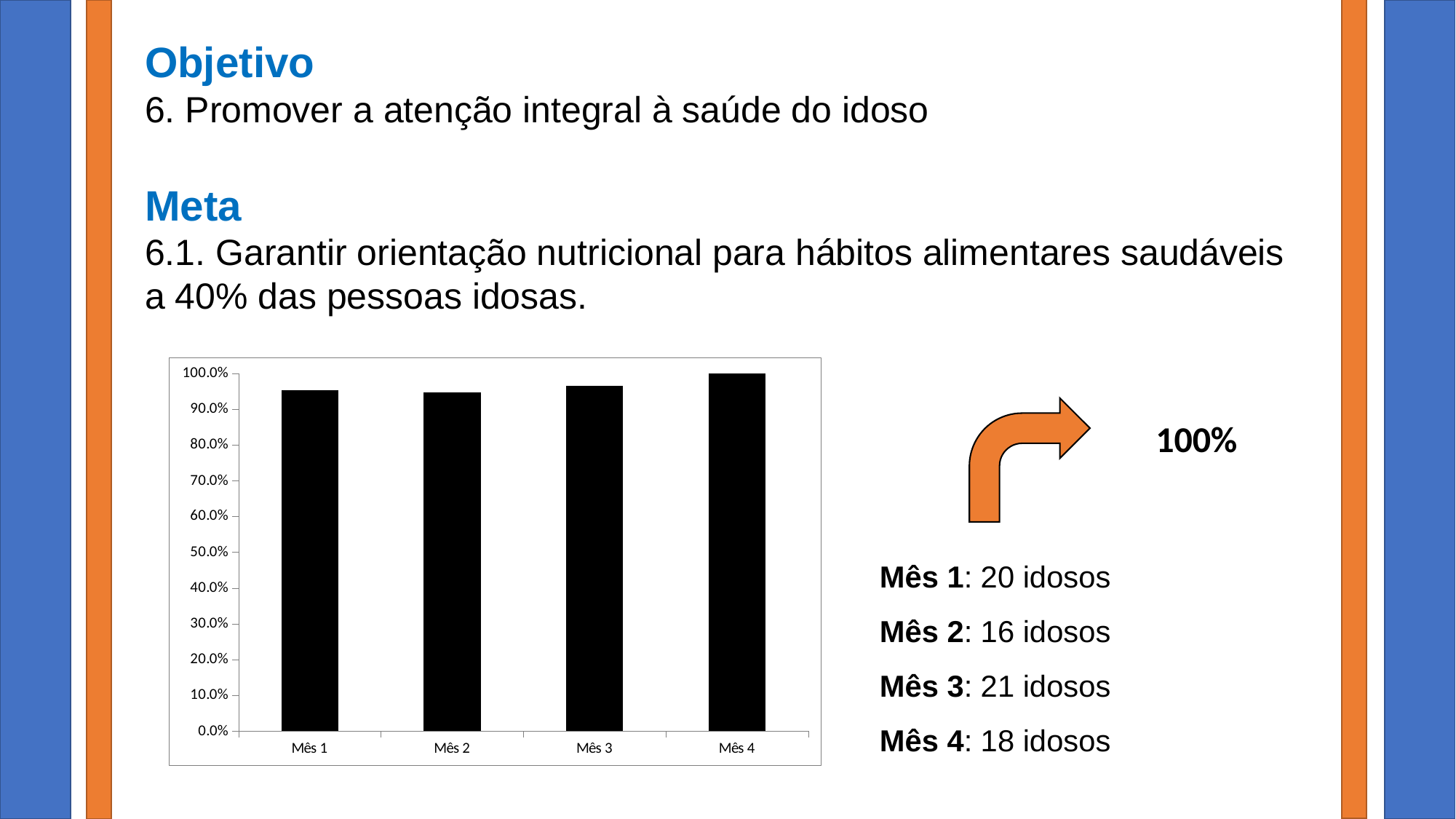
Which is larger, the value for Mês 4 or the value for Mês 2? Mês 4 What value does the bar for Mês 4 reach on the chart? 100.0% Which month has the highest bar on the chart? Mês 4 What colour are the bars in the chart? black Is the value for Mês 2 greater or less than 80.0%? greater What kind of chart is shown on the slide? bar chart Which is larger, the value for Mês 4 or the value for Mês 3? Mês 4 What is the label of the first category on the x axis? Mês 1 How many categories (months) are plotted on the chart? 4 Is the value for Mês 1 greater or less than 100.0%? less Is the value for Mês 1 greater or less than 90.0%? greater